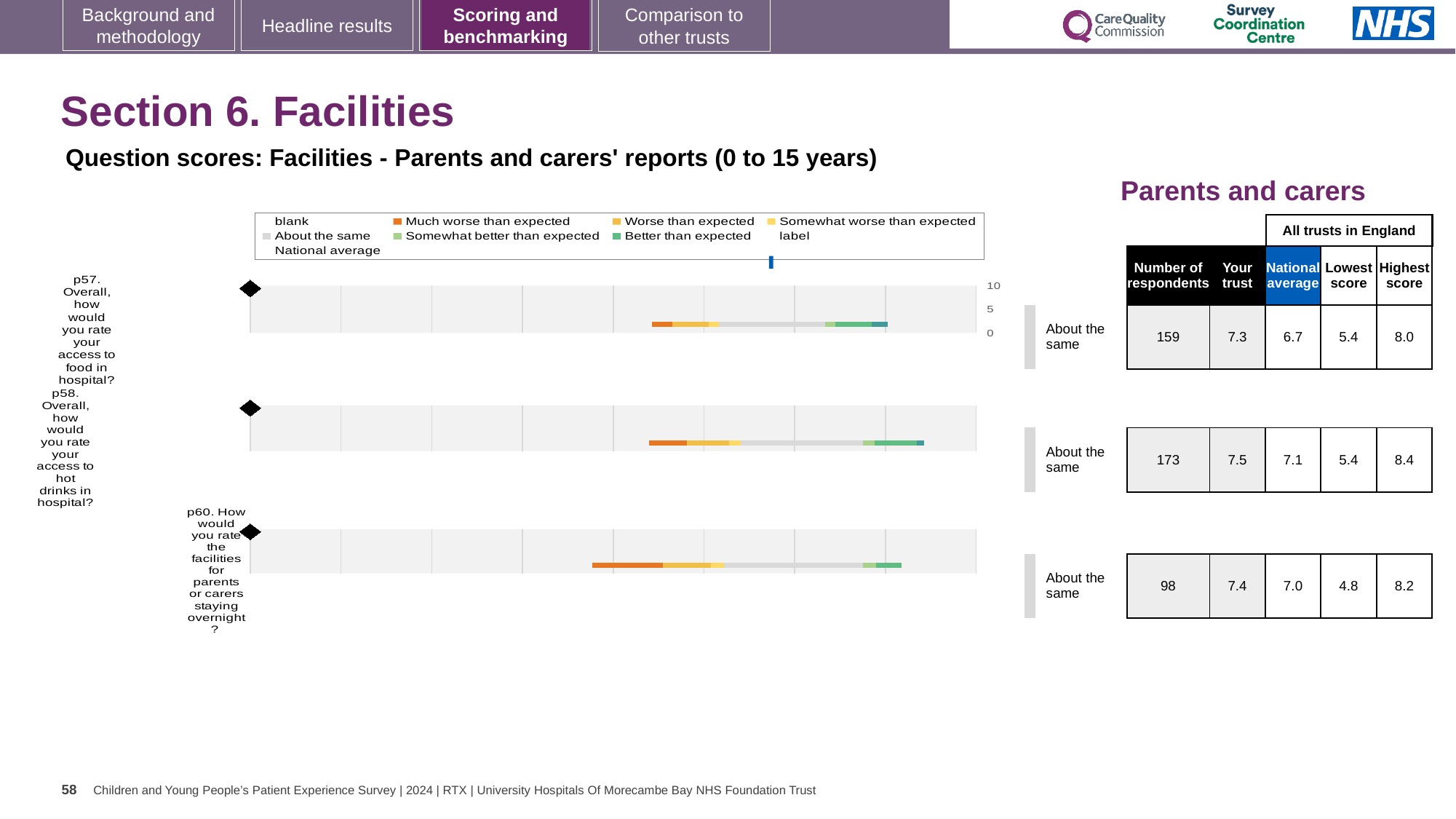
What is the difference between the 'Your trust' score and the national average for p57? 0.6 What is the lowest score among all trusts in England for p60? 4.8 How many respondents answered p60 (facilities for parents or carers staying overnight)? 98 What is the 'Your trust' score for p57 (access to food in hospital)? 7.3 Which of the three questions has the fewest respondents? p60 (facilities for parents or carers staying overnight) What is the maximum value shown on the chart's score axis? 10 What kind of chart is used to show the question scores on this slide? bar chart For p60, is the 'Your trust' score or the national average larger? Your trust What is the national average for p58 (access to hot drinks in hospital)? 7.1 How many questions (categories) are plotted in the chart? 3 Which of the three questions has the highest 'Your trust' score? p58 (access to hot drinks in hospital) What is the highest score among all trusts in England for p58? 8.4